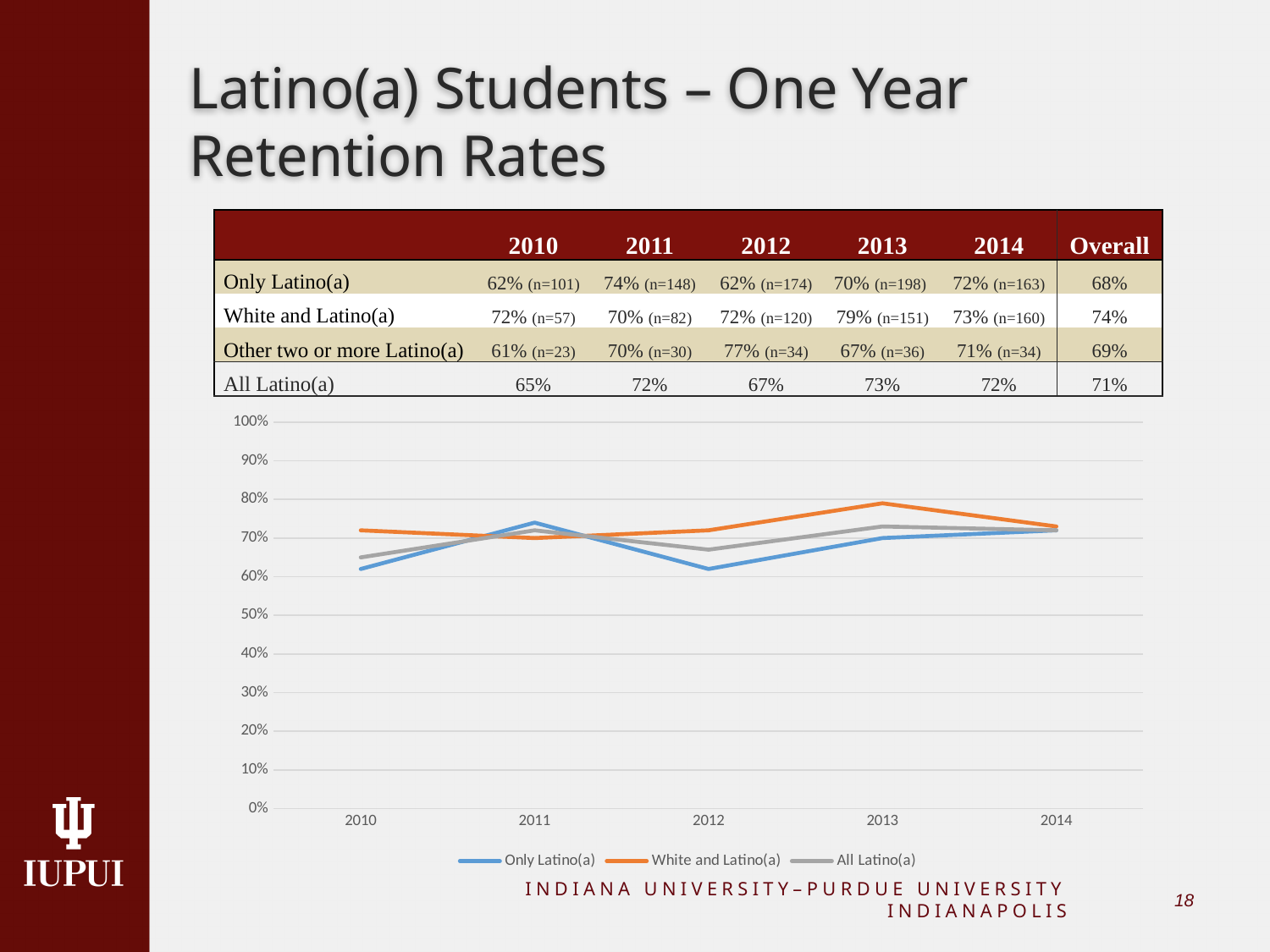
How many series does the chart legend list? 3 Which colour is used for the All Latino(a) line in the chart? Gray In which year did the White and Latino(a) series reach its highest retention rate? 2013 What was the one-year retention rate for Only Latino(a) students in 2011? 74% In which year was the All Latino(a) retention rate lowest? 2010 What is the difference between the White and Latino(a) and Only Latino(a) retention rates in 2012? 10% What type of chart is shown on the slide? Line chart What was the one-year retention rate for All Latino(a) students in 2010? 65% How many years are plotted along the x axis of the chart? 5 Is the Only Latino(a) retention rate in 2012 greater or less than 70%? less What was the one-year retention rate for White and Latino(a) students in 2013? 79% In 2010, which series had the higher retention rate: Only Latino(a) or White and Latino(a)? White and Latino(a)